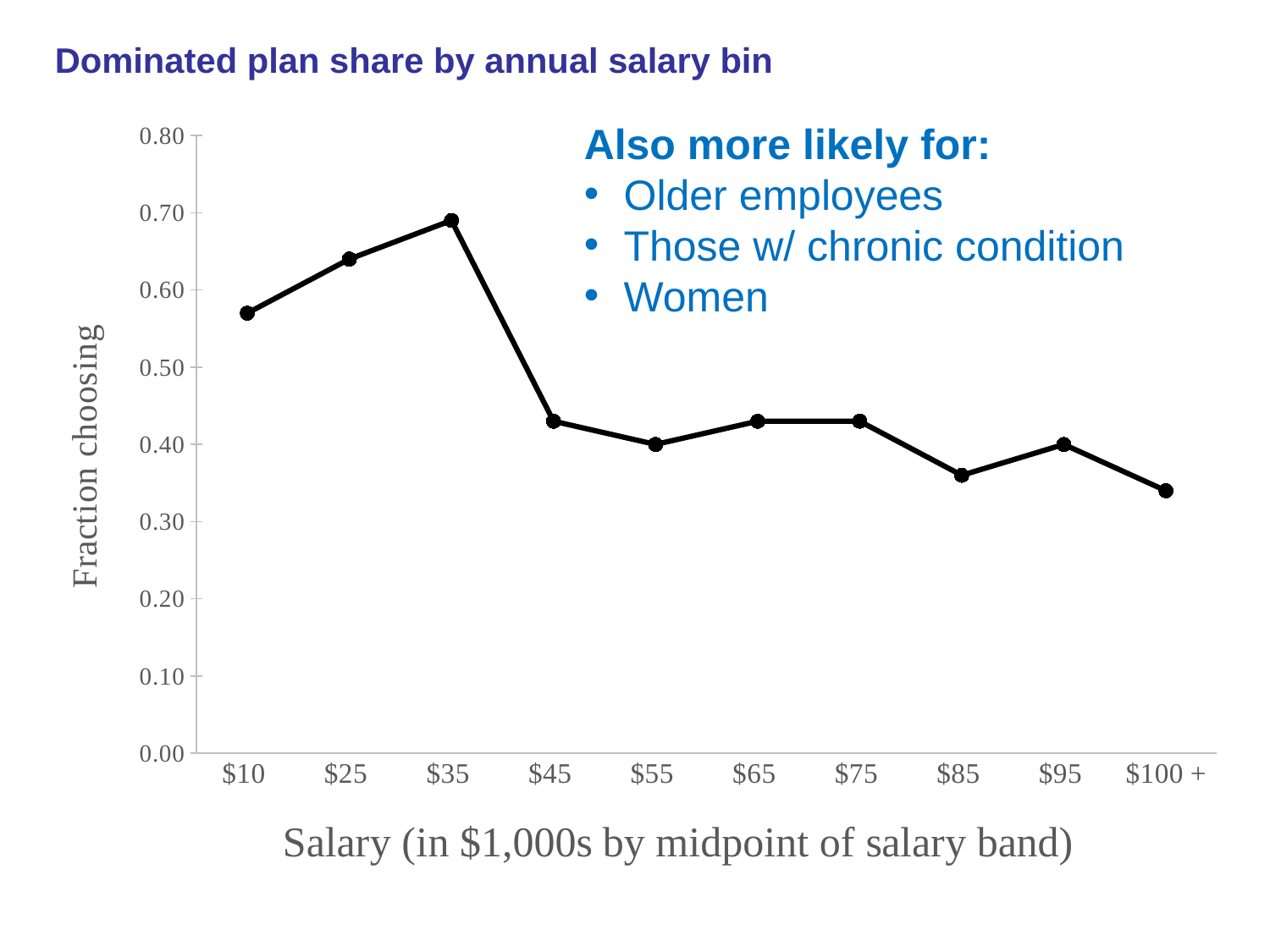
Which has a higher fraction choosing, the $25 bin or the $45 bin? $25 Is the fraction choosing for the $10 salary bin greater or less than 0.50? greater Which salary bin has the highest fraction choosing? $35 Overall, does the fraction choosing rise or fall as salary increases from $10 to $100 +? fall Is the fraction choosing for the $45 salary bin greater or less than 0.50? less What is the label on the vertical axis of the chart? Fraction choosing What is the title of the chart? Dominated plan share by annual salary bin Is the fraction choosing for the $25 salary bin greater or less than 0.60? greater How many salary bins are plotted on the x axis? 10 What kind of chart is shown on the slide? line chart